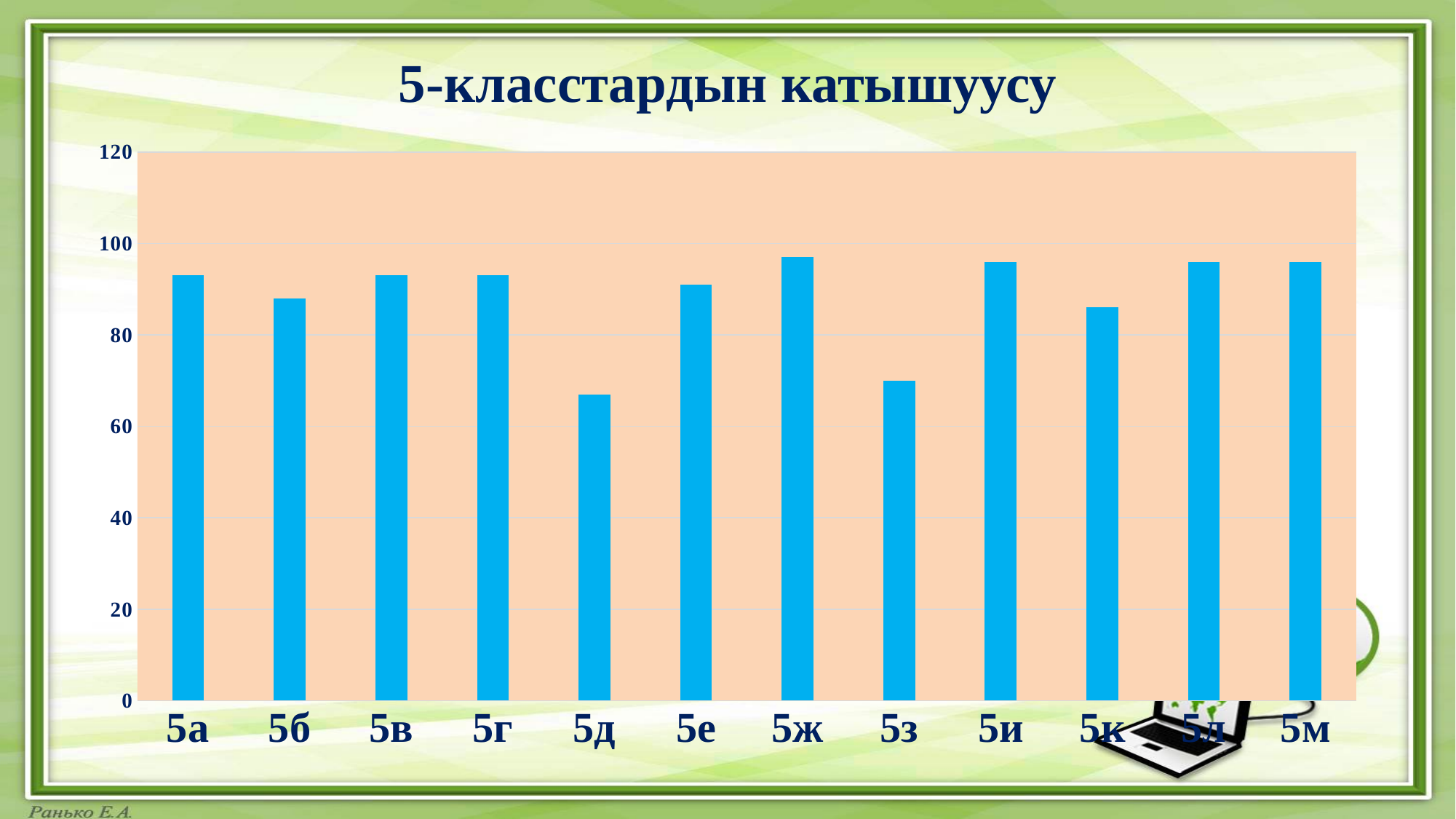
Is the value for 5з greater or less than 80? less Which class has the lowest bar? 5д How many classes (categories) are shown on the x axis? 12 What is the title of the chart? 5-класстардын катышуусу Is the value for 5д greater or less than 80? less Which is larger, the value for 5а or the value for 5д? 5а Is the value for 5к greater or less than 100? less What colour are the bars in the chart? blue Which is larger, the value for 5д or the value for 5з? 5з What kind of chart is shown on the slide? bar chart